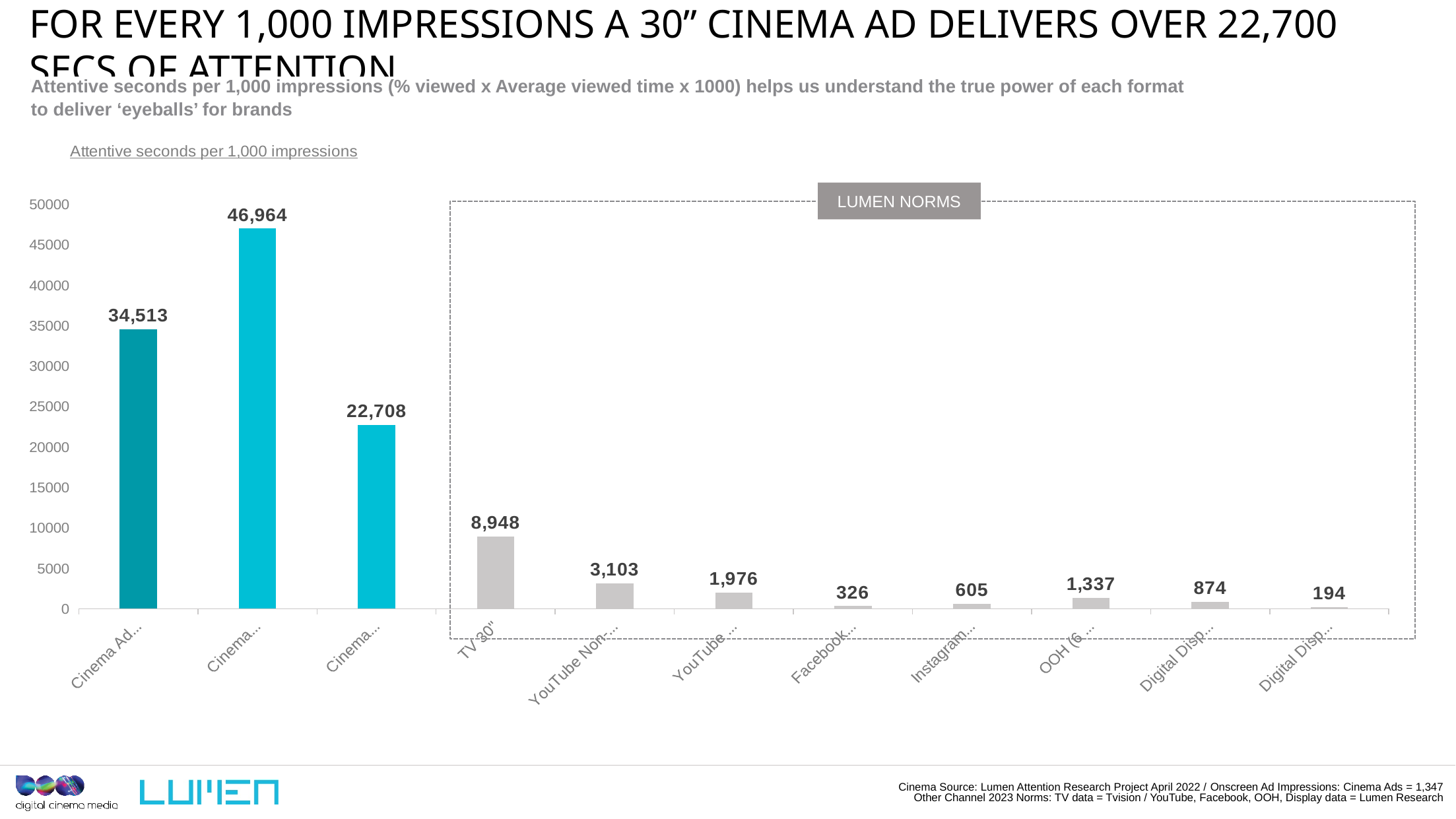
What is the value for Instagram? 605 What is the value for Facebook? 326 How many bars are plotted in the chart? 11 What is the title of the chart? Attentive seconds per 1,000 impressions What kind of chart is shown on the slide? bar chart What is the highest value shown in the chart? 46,964 Which has the larger value, Instagram or Facebook? Instagram What is the value for OOH? 1,337 What is the difference between the values for TV 30" and Facebook? 8,622 Is the value for TV 30" greater or less than 10000? less What is the value for TV 30"? 8,948 What is the lowest value shown in the chart? 194